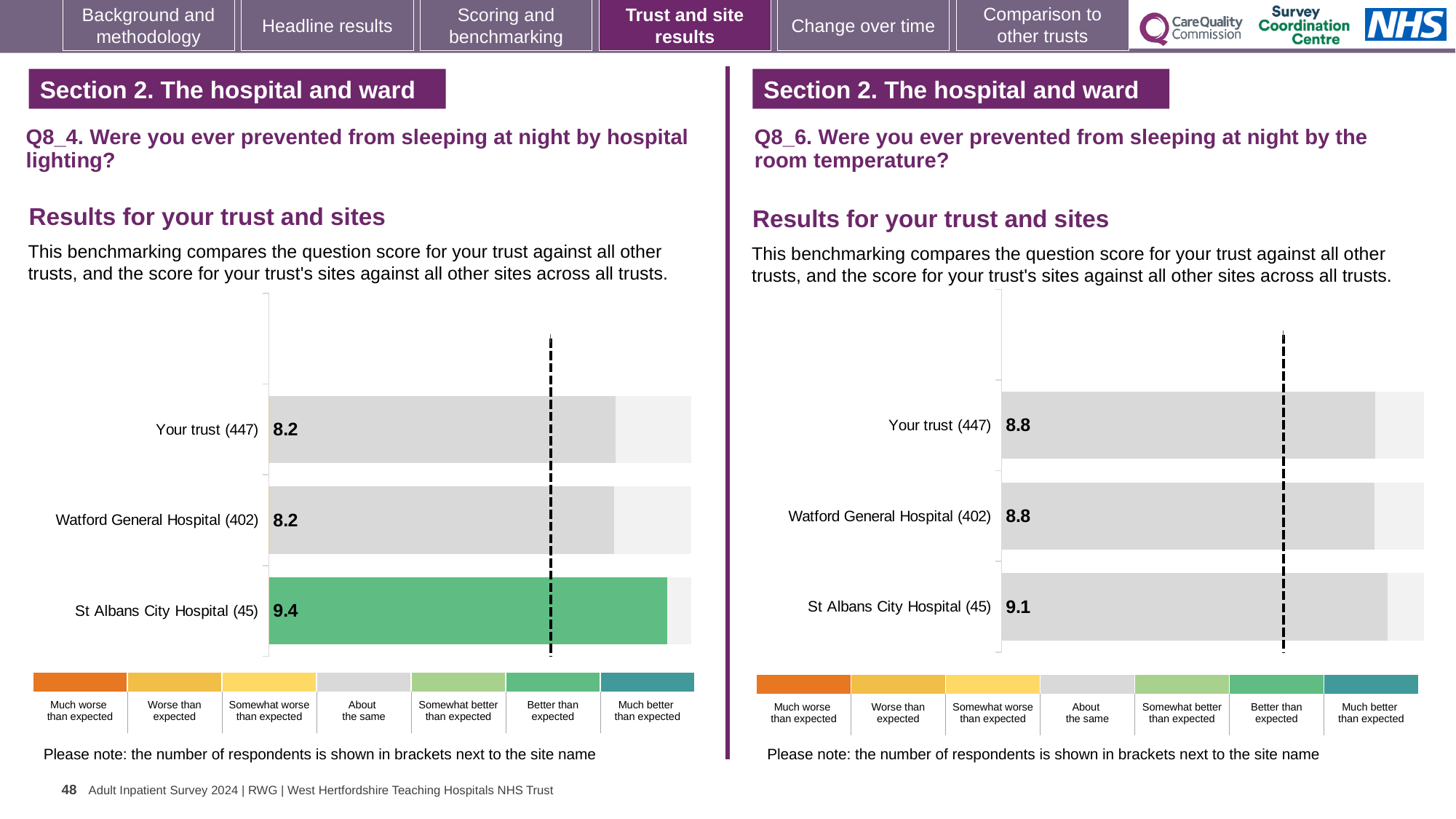
On the Q8_6 room temperature chart, what is the score for Watford General Hospital (402)? 8.8 On the Q8_6 room temperature chart, what is the score for St Albans City Hospital (45)? 9.1 On the Q8_6 room temperature chart, which site or trust has the highest score? St Albans City Hospital (45) On the Q8_6 room temperature chart, what is the difference between the St Albans City Hospital score and the Your trust score? 0.3 On the Q8_6 room temperature chart, which is larger: the score for St Albans City Hospital or the score for Watford General Hospital? St Albans City Hospital How many bars are plotted on the Q8_4 hospital lighting chart? 3 On the Q8_4 hospital lighting chart, which bar is coloured green rather than grey? St Albans City Hospital (45) On the Q8_4 hospital lighting chart, which site or trust has the highest score? St Albans City Hospital (45) On the Q8_4 hospital lighting chart, what is the difference between the St Albans City Hospital score and the Watford General Hospital score? 1.2 What kind of chart is used on the Q8_6 room temperature chart? Bar chart On the Q8_4 hospital lighting chart, what is the score for St Albans City Hospital (45)? 9.4 On the Q8_4 hospital lighting chart, what is the score for Your trust (447)? 8.2